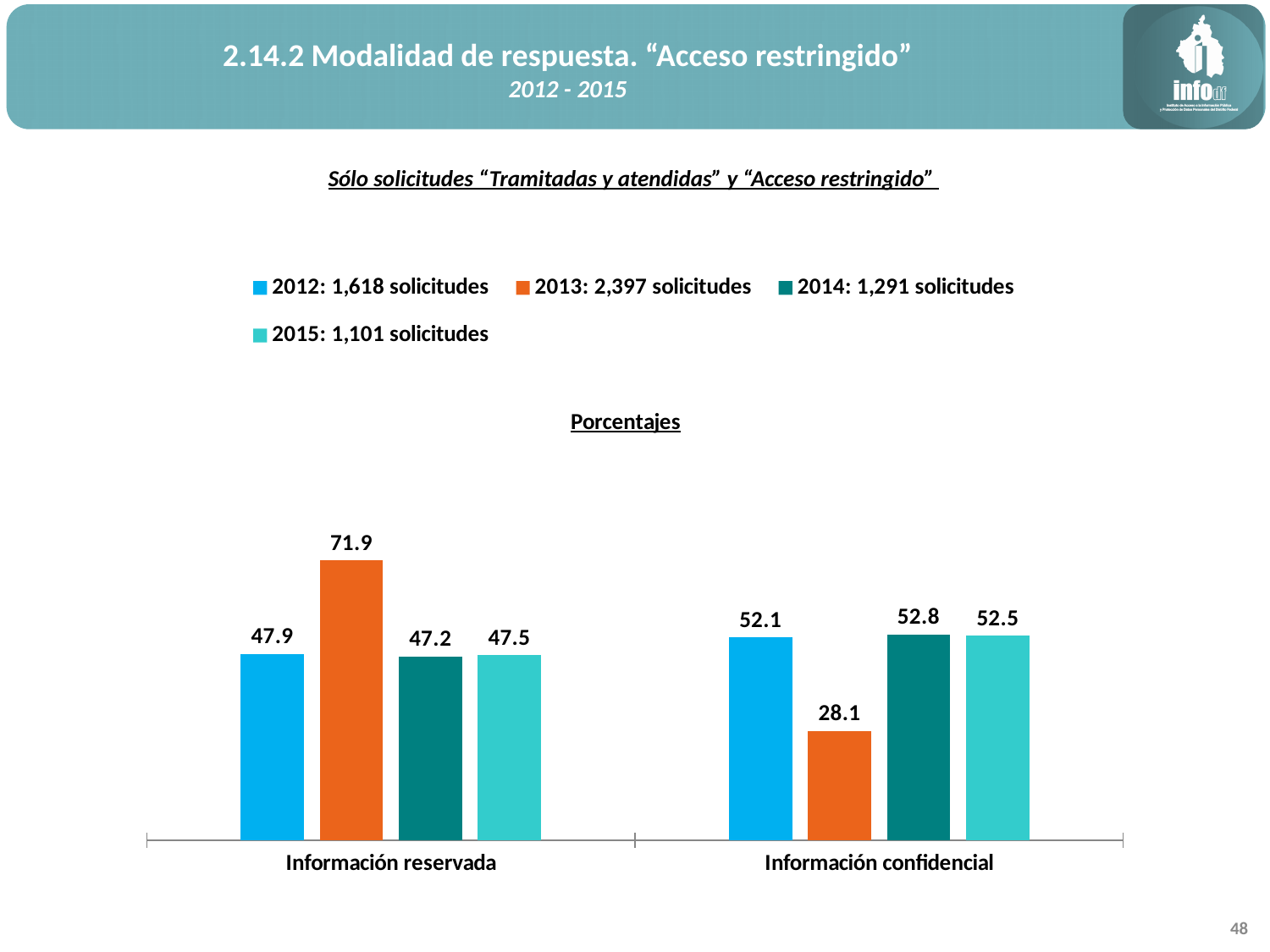
What is the value for 2013 in the Información reservada category? 71.9 How many series does the legend list? 4 What is the value for 2013 in the Información confidencial category? 28.1 According to the legend, how many solicitudes were there in 2013? 2,397 How many categories are shown on the x axis? 2 What is the difference between the 2013 values for Información reservada and Información confidencial? 43.8 Which year has the lowest value in the Información confidencial category? 2013 What is the value for 2015 in the Información reservada category? 47.5 What is the value for 2014 in the Información confidencial category? 52.8 Which year has the highest value in the Información reservada category? 2013 Which is larger: the 2012 value for Información reservada or the 2012 value for Información confidencial? Información confidencial What kind of chart is shown on the slide? Bar chart